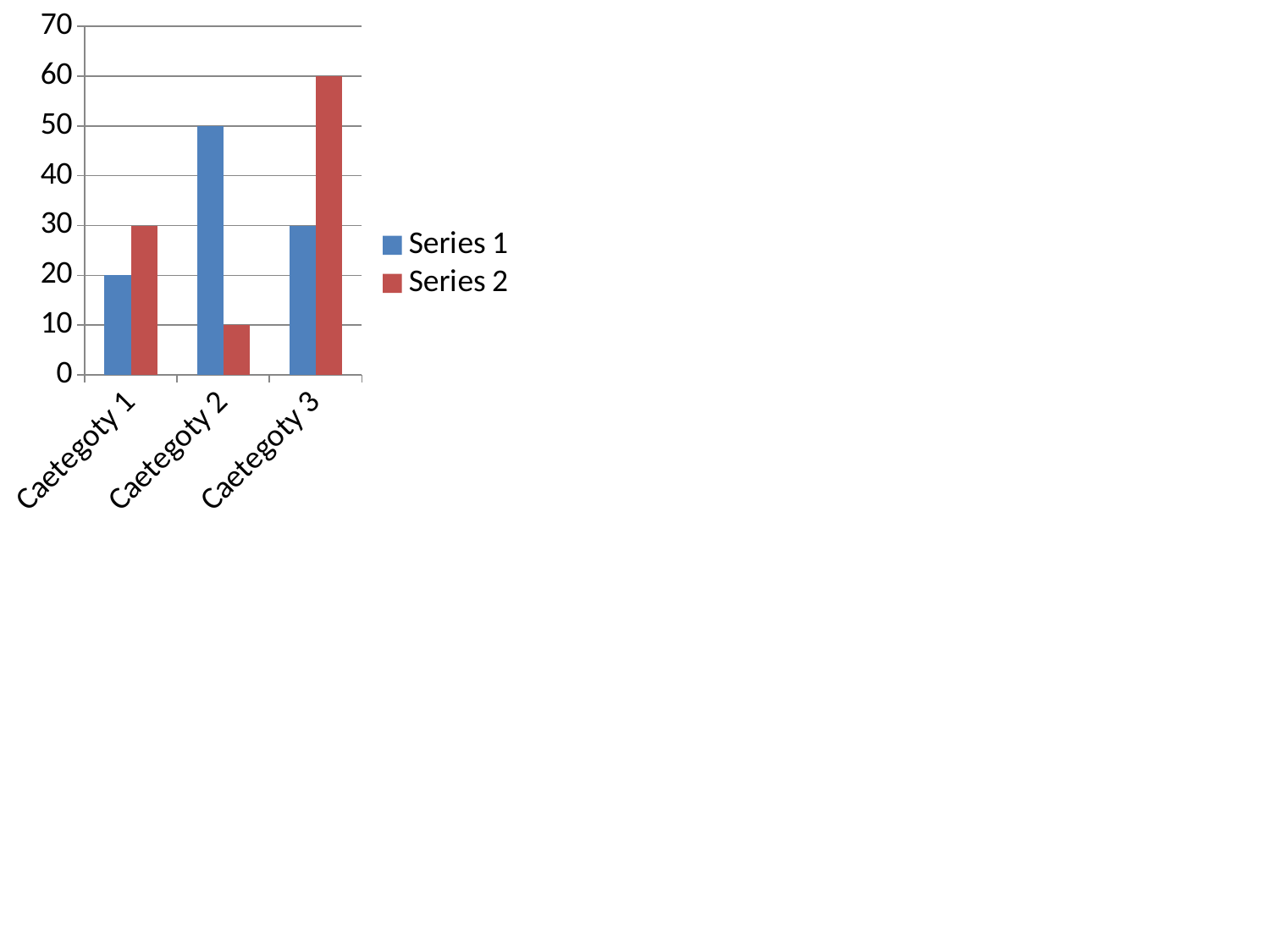
What colour are the Series 2 bars? red What is the value of Series 2 for Caetegoty 2? 10 Which category has the highest value for Series 1? Caetegoty 2 What is the difference between Series 2 and Series 1 for Caetegoty 3? 30 Is the value of Series 1 for Caetegoty 3 greater or less than 40? less Which category has the lowest value for Series 2? Caetegoty 2 What is the value of Series 1 for Caetegoty 2? 50 For Caetegoty 1, which series has the larger value? Series 2 What kind of chart is shown on the slide? bar chart How many categories are shown on the x axis? 3 How many series does the legend list? 2 What is the value of Series 2 for Caetegoty 3? 60